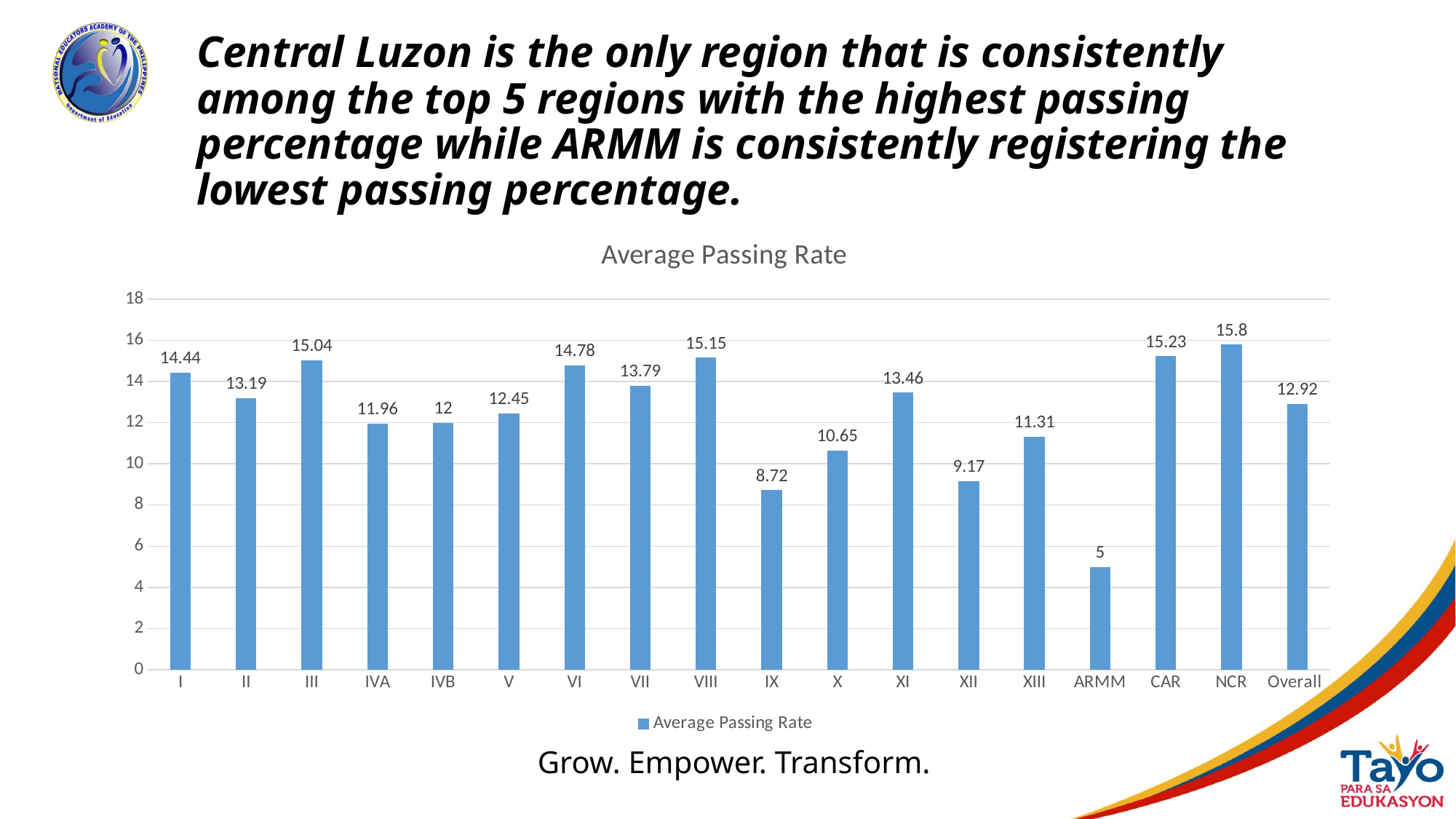
What is the average passing rate for ARMM? 5 How many categories are shown on the x axis of the chart? 18 How many series does the legend list? 1 What is the title of the chart? Average Passing Rate Which category has the lowest average passing rate? ARMM What is the difference between the average passing rates of NCR and ARMM? 10.8 Which has a higher average passing rate, region VIII or region IX? VIII What is the Overall average passing rate shown in the chart? 12.92 Which category has the highest average passing rate? NCR Is the value for region XII greater or less than 10? less What kind of chart is shown on the slide? bar chart What is the average passing rate for region III? 15.04